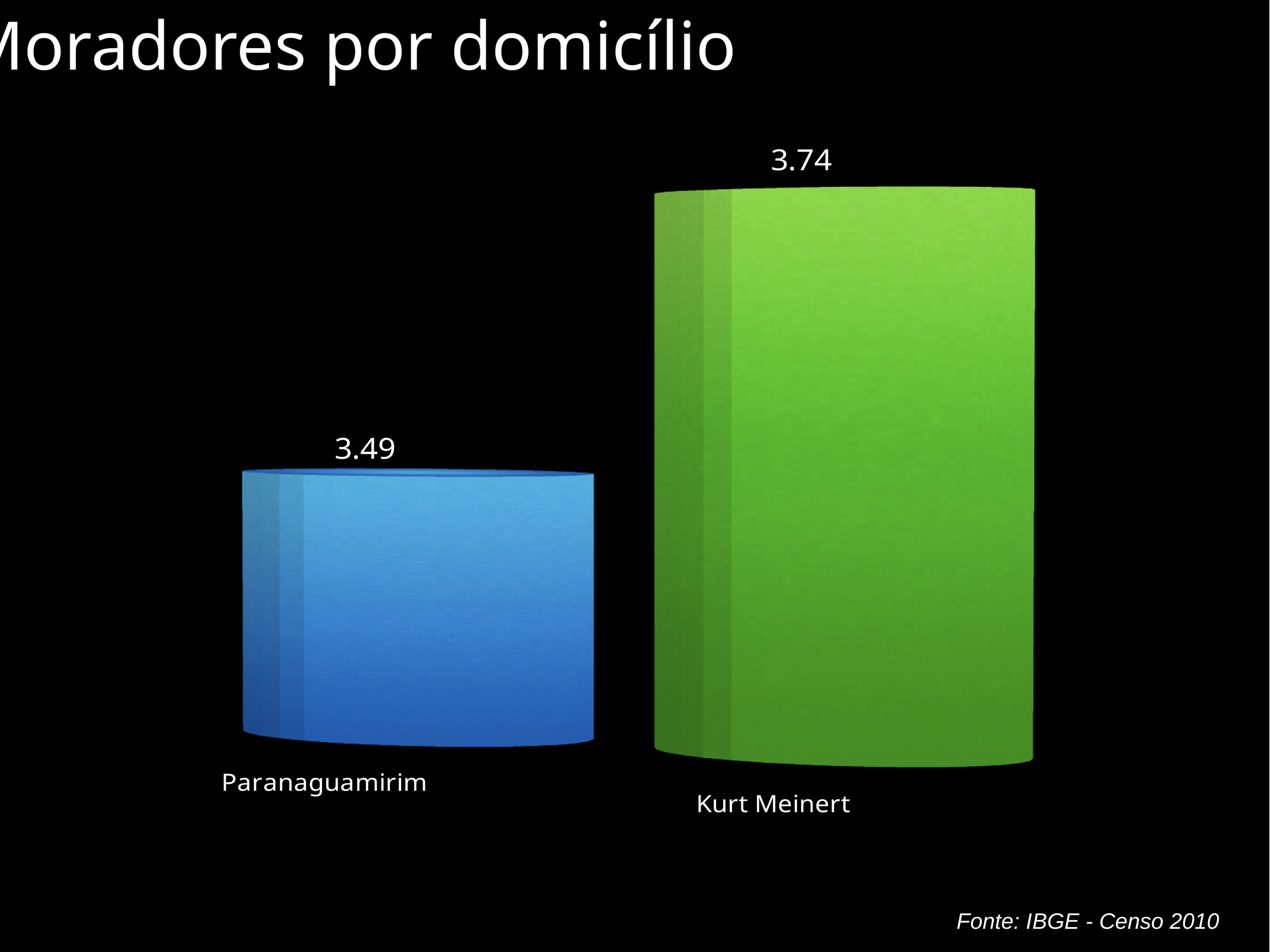
What kind of chart is shown on the slide? Bar chart What is the difference between the values for Kurt Meinert and Paranaguamirim? 0.25 Which is larger, the value for Paranaguamirim or the value for Kurt Meinert? Kurt Meinert Which category has the lowest value? Paranaguamirim What colour is the bar for Kurt Meinert? Green What is the title of the slide? Moradores por domicílio What is the value for Kurt Meinert? 3.74 How many categories are shown in the chart? 2 What is the value for Paranaguamirim? 3.49 Which category has the highest value? Kurt Meinert